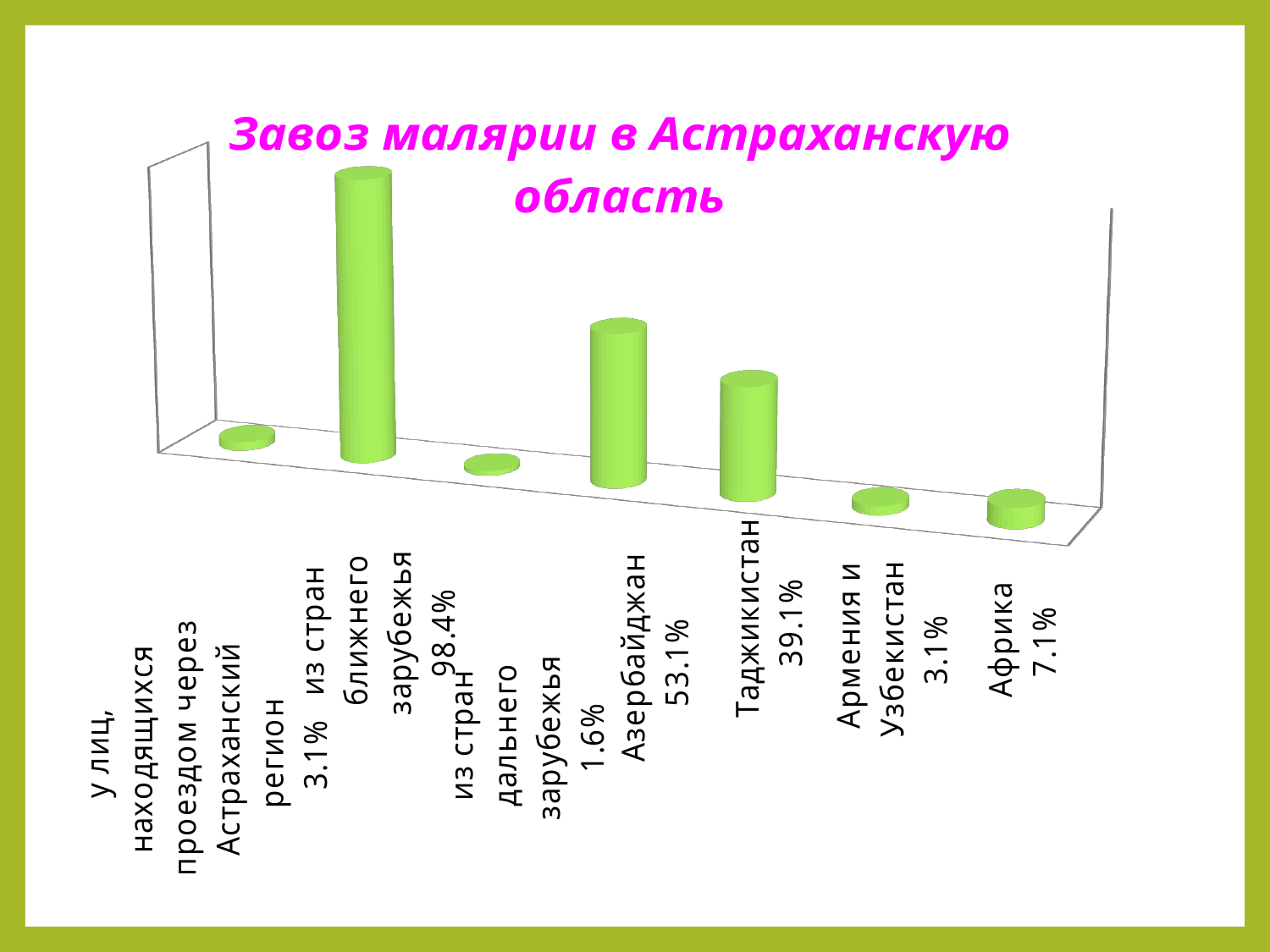
Which category has the highest value? из стран ближнего зарубежья What is the title of the chart? Завоз малярии в Астраханскую область What is the value for Таджикистан? 39.1% Which is larger, the value for Африка or the value for «Армения и Узбекистан»? Африка How many categories are shown in the chart? 7 What kind of chart is shown on the slide? Bar chart What is the value for Африка? 7.1% Which category has the lowest value? из стран дальнего зарубежья What is the difference between the values for Азербайджан and Таджикистан? 14.0% What is the value for Азербайджан? 53.1% What is the value for «из стран ближнего зарубежья»? 98.4% What is the value for «из стран дальнего зарубежья»? 1.6%